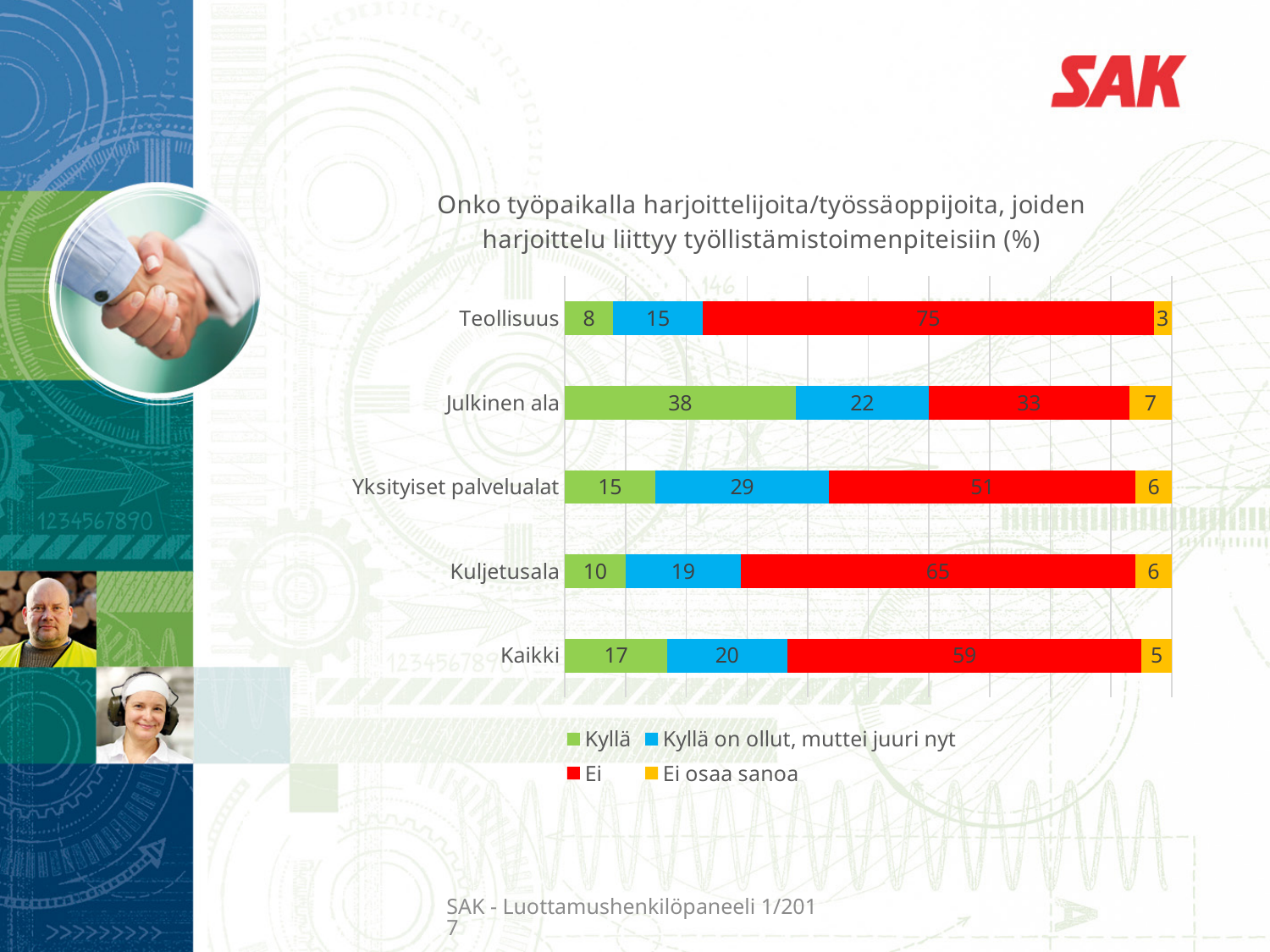
What is the difference between the "Ei" values for Kuljetusala and Julkinen ala? 32 What is the value of "Ei" for Teollisuus? 75 What kind of chart is shown on the slide? Stacked bar chart How many categories are shown on the chart? 5 What is the value of "Kyllä" for Julkinen ala? 38 Which category has the highest value for "Ei"? Teollisuus What is the value of "Kyllä on ollut, muttei juuri nyt" for Yksityiset palvelualat? 29 What is the total of the stacked bar for Julkinen ala? 100 What is the value of "Ei osaa sanoa" for Kuljetusala? 6 Which category has the lowest value for "Kyllä"? Teollisuus How many series does the legend list? 4 Which is larger: the "Kyllä" value for Kaikki or the "Kyllä" value for Yksityiset palvelualat? Kaikki